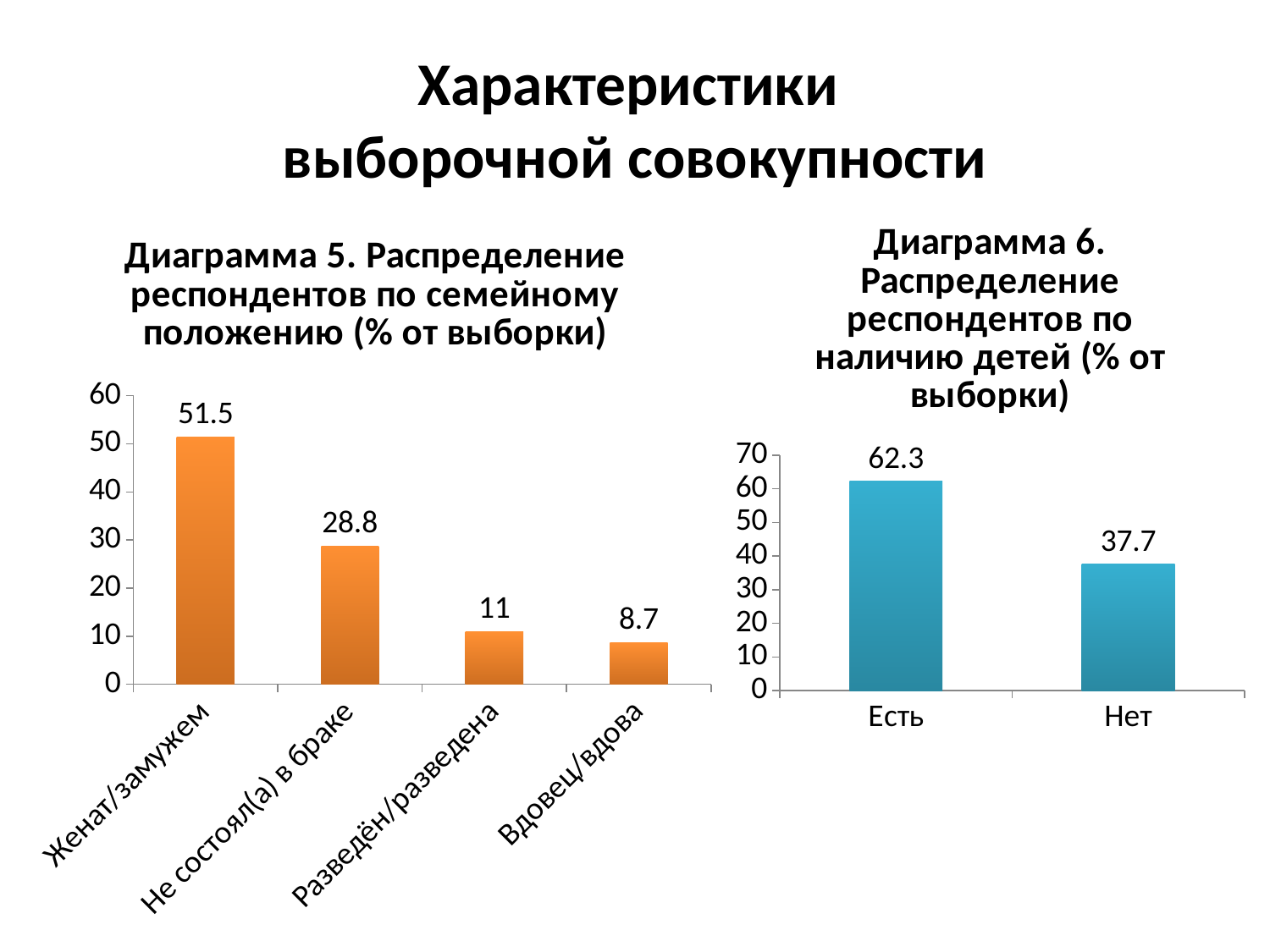
In Диаграмма 5 (left chart), is the value for Разведён/разведена greater or less than 20? less In Диаграмма 5 (left chart), which category has the highest value? Женат/замужем In Диаграмма 5 (left chart), what is the difference between the values for Женат/замужем and Не состоял(а) в браке? 22.7 What type of chart is Диаграмма 6 (right chart)? Bar chart In Диаграмма 5 (left chart), what is the value for Женат/замужем? 51.5 In Диаграмма 5 (left chart), what is the value for Не состоял(а) в браке? 28.8 In Диаграмма 6 (right chart), what is the value for Есть? 62.3 In Диаграмма 5 (left chart), which category has the lowest value? Вдовец/вдова In Диаграмма 5 (left chart), how many categories are shown? 4 In Диаграмма 6 (right chart), which is larger, Есть or Нет? Есть In Диаграмма 6 (right chart), what is the difference between the values for Есть and Нет? 24.6 In Диаграмма 6 (right chart), what is the value for Нет? 37.7